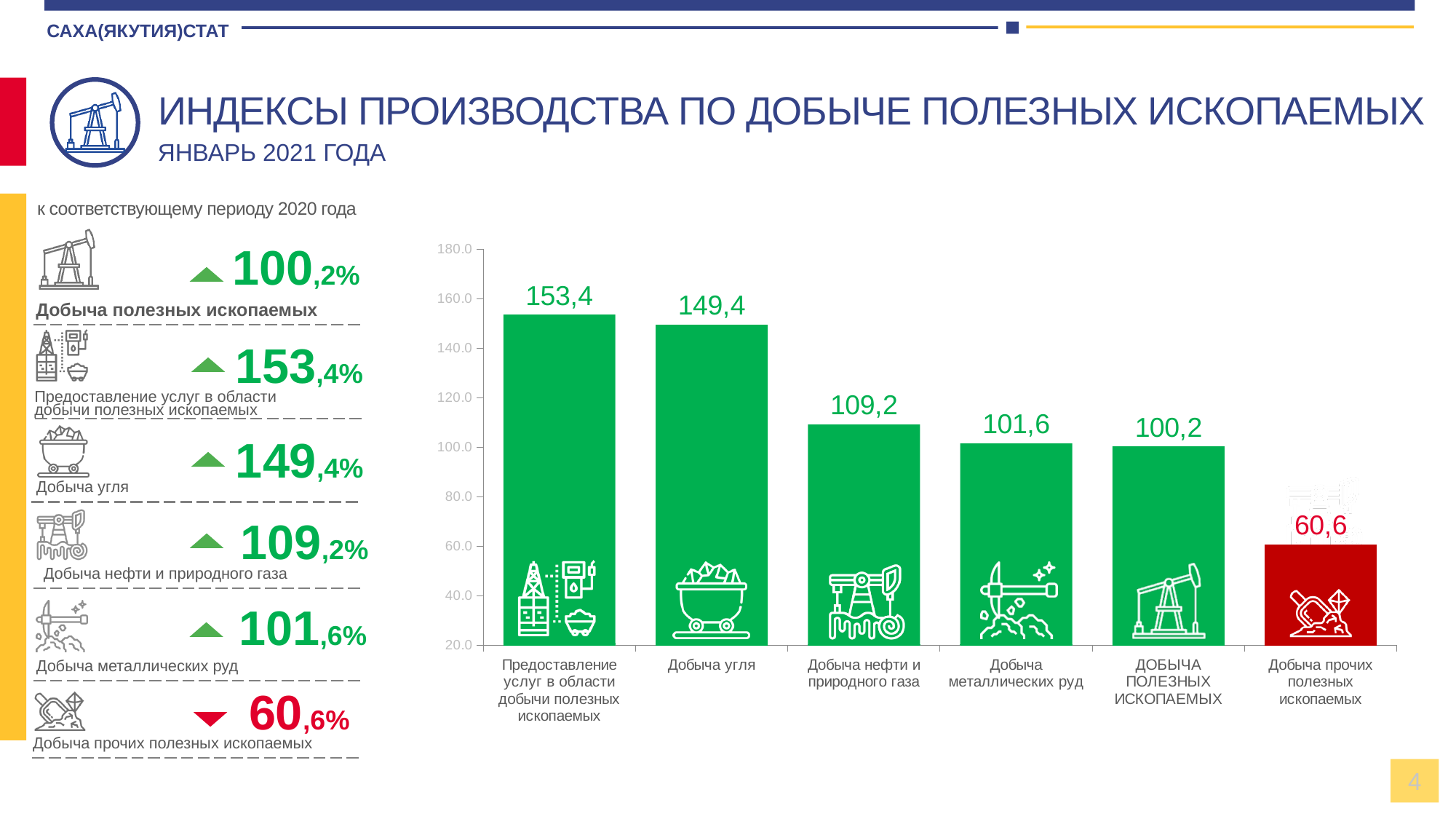
What is the value for Добыча угля? 149,4 What is the value for ДОБЫЧА ПОЛЕЗНЫХ ИСКОПАЕМЫХ? 100,2 Which bar is coloured red instead of green? Добыча прочих полезных ископаемых What is the value for Добыча прочих полезных ископаемых? 60,6 Which category has the highest value? Предоставление услуг в области добычи полезных ископаемых Which category has the lowest value? Добыча прочих полезных ископаемых How many categories are shown in the bar chart? 6 What kind of chart is shown on the slide? bar chart Which is larger, the value for Добыча металлических руд or the value for Добыча прочих полезных ископаемых? Добыча металлических руд What is the difference between the values for Добыча угля and Добыча нефти и природного газа? 40,2 Do the values rise or fall from left to right across the categories? fall What is the value for Добыча нефти и природного газа? 109,2